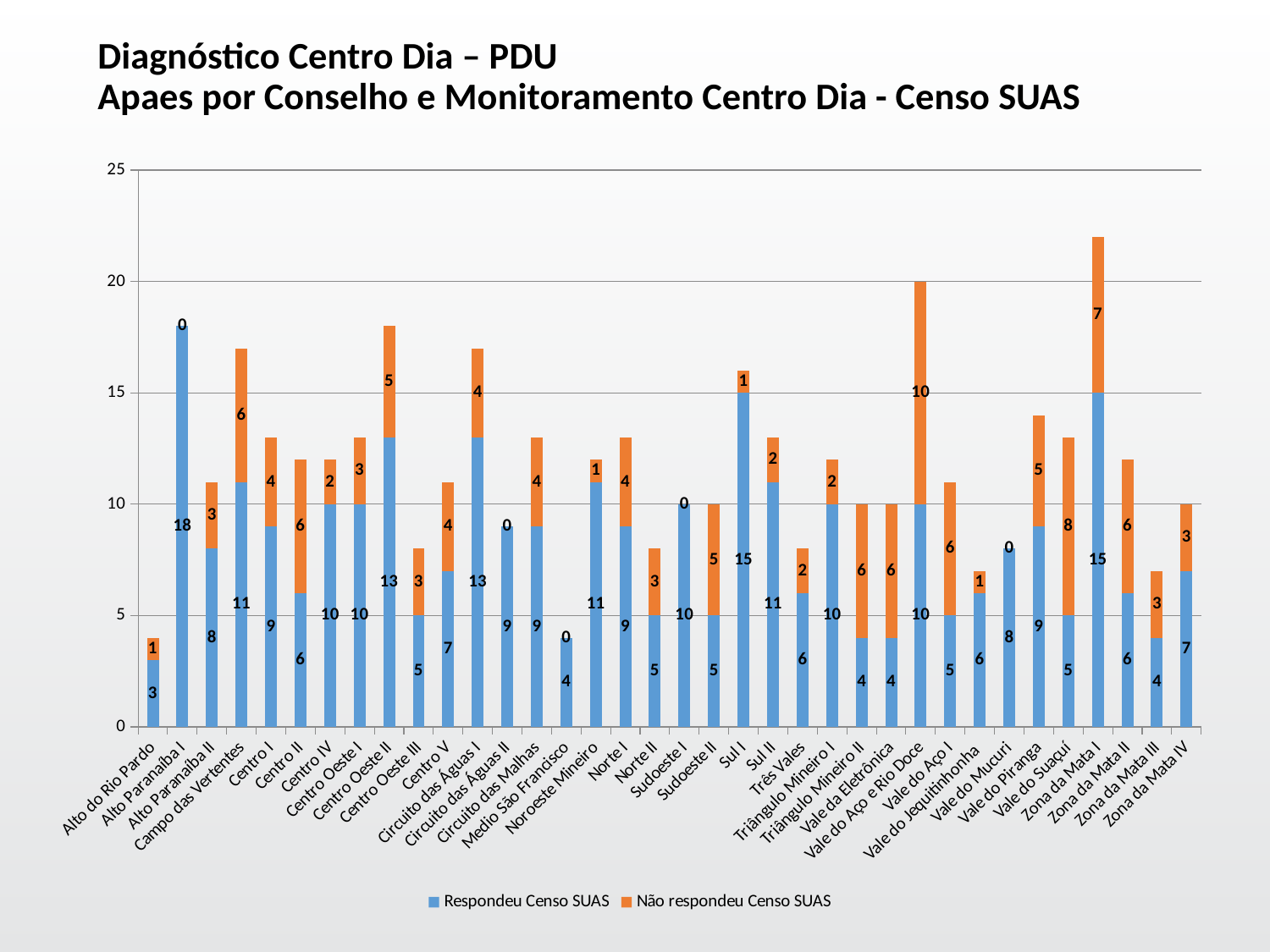
What is the value of Respondeu Censo SUAS for Alto Paranaíba I? 18 Which category has the highest value for Não respondeu Censo SUAS? Vale do Aço e Rio Doce For Campo das Vertentes, what is the difference between Respondeu Censo SUAS and Não respondeu Censo SUAS? 5 Which category has the lowest value for Respondeu Censo SUAS? Alto do Rio Pardo What is the value of Não respondeu Censo SUAS for Vale do Aço e Rio Doce? 10 What is the total of the stacked bar for Vale do Aço e Rio Doce? 20 How many series does the legend list? 2 Which has a larger Respondeu Censo SUAS value, Sul I or Centro Oeste II? Sul I What is the value of Respondeu Censo SUAS for Médio São Francisco? 4 What is the total of the stacked bar for Zona da Mata I? 22 Which category has the highest value for Respondeu Censo SUAS? Alto Paranaíba I What kind of chart is shown on the slide? Stacked bar chart